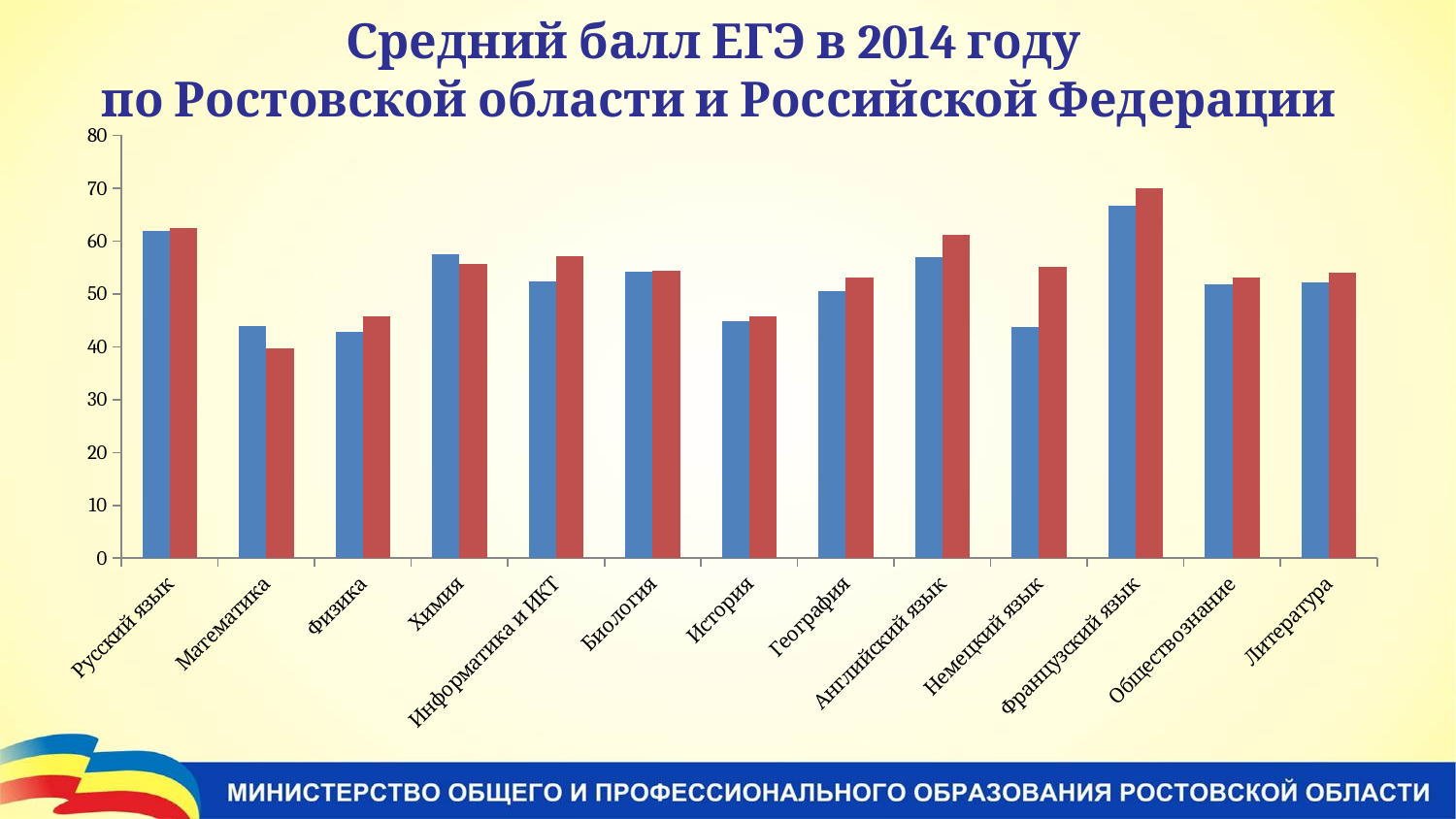
For Математика, which bar is taller, the blue one or the red one? blue Is the blue bar for Французский язык greater or less than 60? greater Which subject has the highest red bar in the chart? Французский язык Which subject has the highest blue bar in the chart? Французский язык How many bars are plotted for each subject in the chart? 2 How many subjects are shown along the x axis of the chart? 13 Which subject has the lowest red bar in the chart? Математика Is the blue bar for История greater or less than 50? less What year does the chart title say the average ЕГЭ scores are for? 2014 For Немецкий язык, which bar is taller, the blue one or the red one? red What kind of chart is shown on the slide? bar chart Is the red bar for Английский язык greater or less than 60? greater